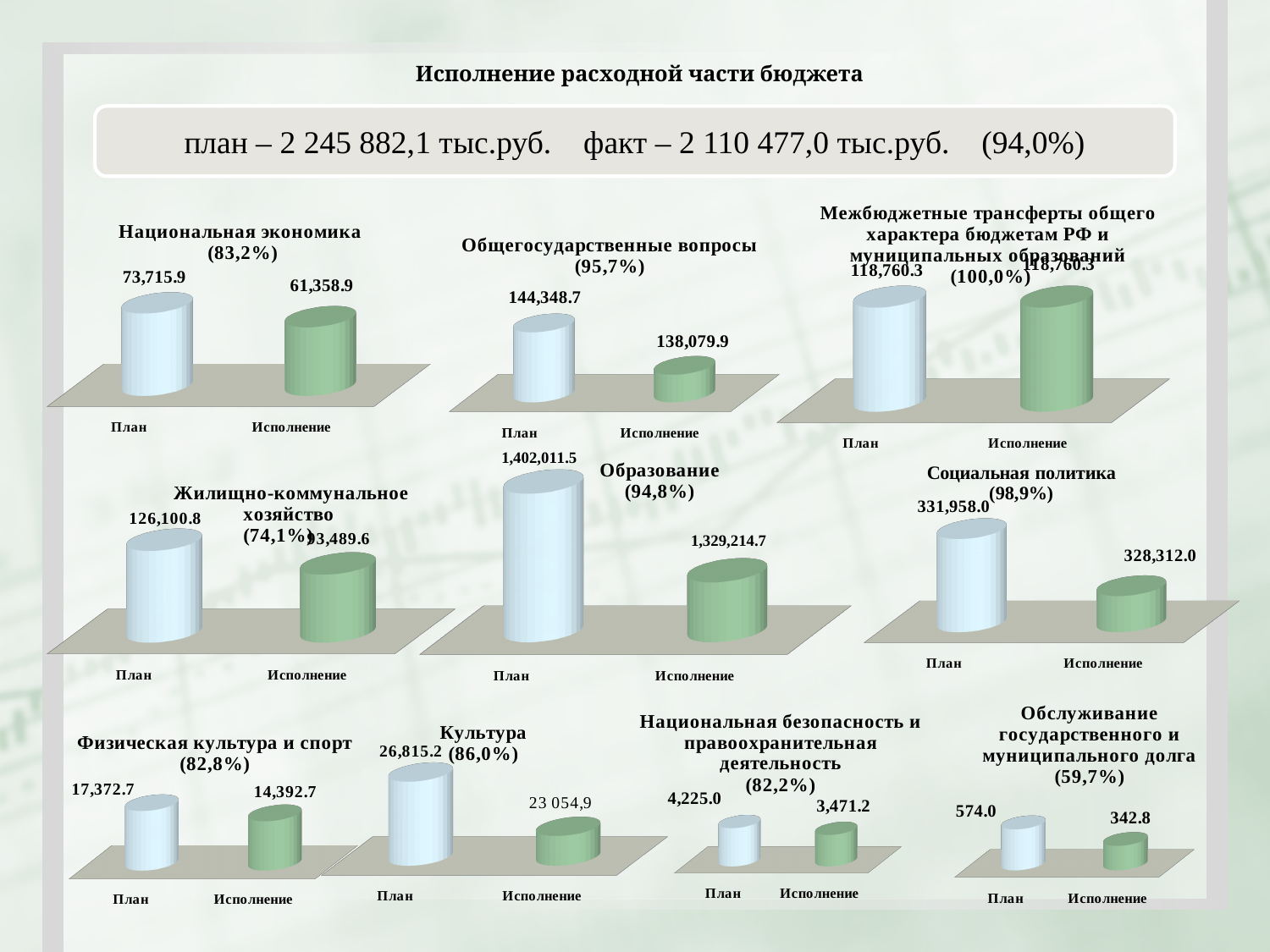
How many categories does the 'Образование' chart show? 2 What is the title of the slide? Исполнение расходной части бюджета In the 'Образование' chart, what is the value for План? 1,402,011.5 In the 'Социальная политика' chart, what is the value for Исполнение? 328,312.0 In the 'Физическая культура и спорт' chart, which is larger, План or Исполнение? План In the 'Национальная экономика' chart, what is the value for План? 73,715.9 In the 'Национальная безопасность и правоохранительная деятельность' chart, what is the difference between План and Исполнение? 753.8 In the 'Культура' chart, what is the value for План? 26,815.2 In the 'Национальная экономика' chart, what is the value for Исполнение? 61,358.9 What kind of chart is used for 'Социальная политика'? Bar chart In the 'Обслуживание государственного и муниципального долга' chart, what is the difference between План and Исполнение? 231.2 In the 'Общегосударственные вопросы' chart, what is the value for Исполнение? 138,079.9